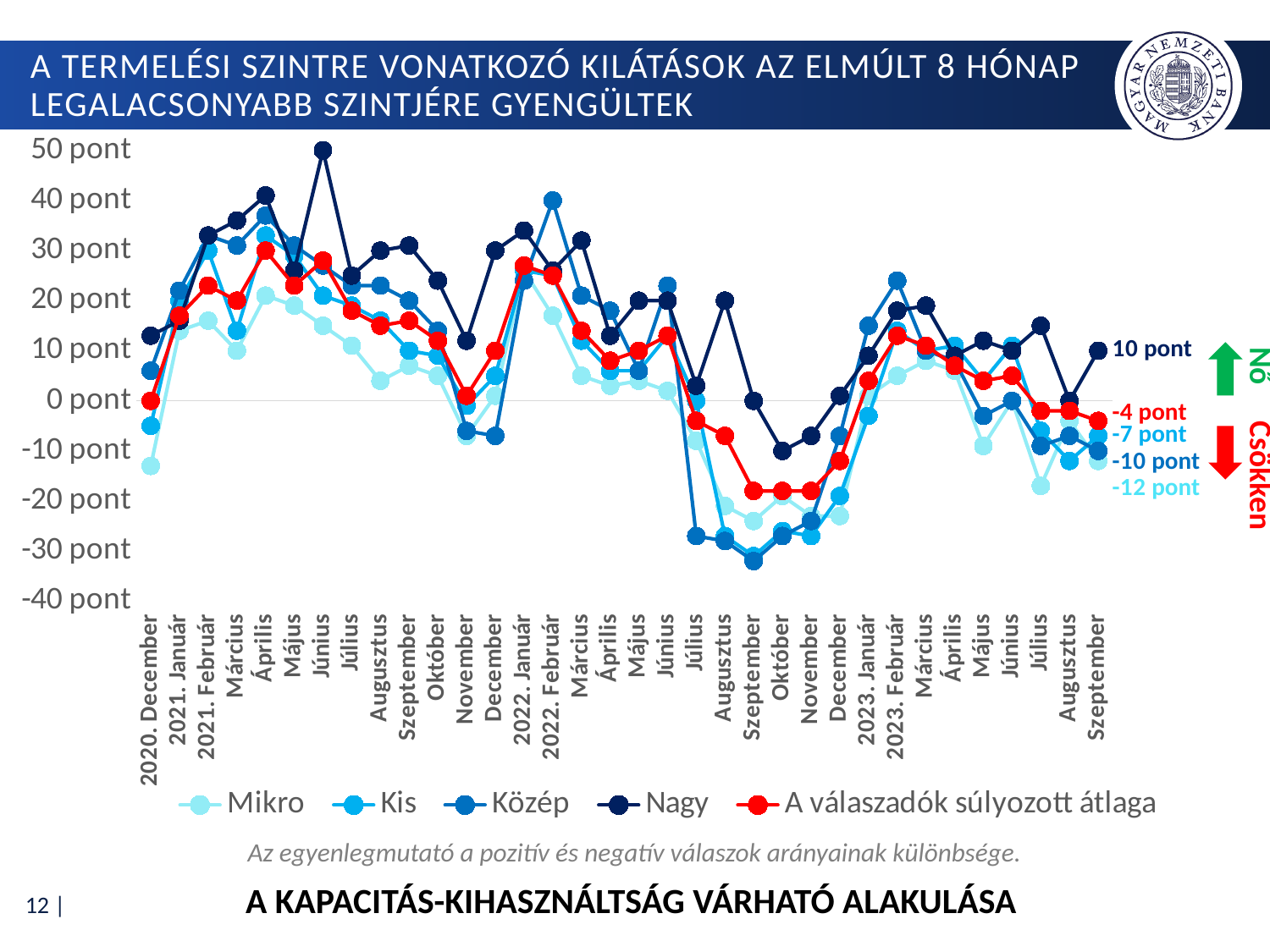
What is the value for A válaszadók súlyozott átlaga in 2023 Szeptember? -4 pont Is the value for Nagy in 2021 Június greater or less than 40 pont? greater How many series does the legend list? 5 What is the value for Nagy in 2023 Szeptember? 10 pont What is the difference between the Nagy and Mikro values in 2023 Szeptember? 22 pont What kind of chart is shown on the slide? line chart Which series has the highest value in 2023 Szeptember? Nagy What is the value for Mikro in 2023 Szeptember? -12 pont What is the value for Kis in 2023 Szeptember? -7 pont Does the A válaszadók súlyozott átlaga series rise or fall from 2023 Február to 2023 Szeptember? fall What is the value for Közép in 2023 Szeptember? -10 pont Which series has the lowest value in 2023 Szeptember? Mikro